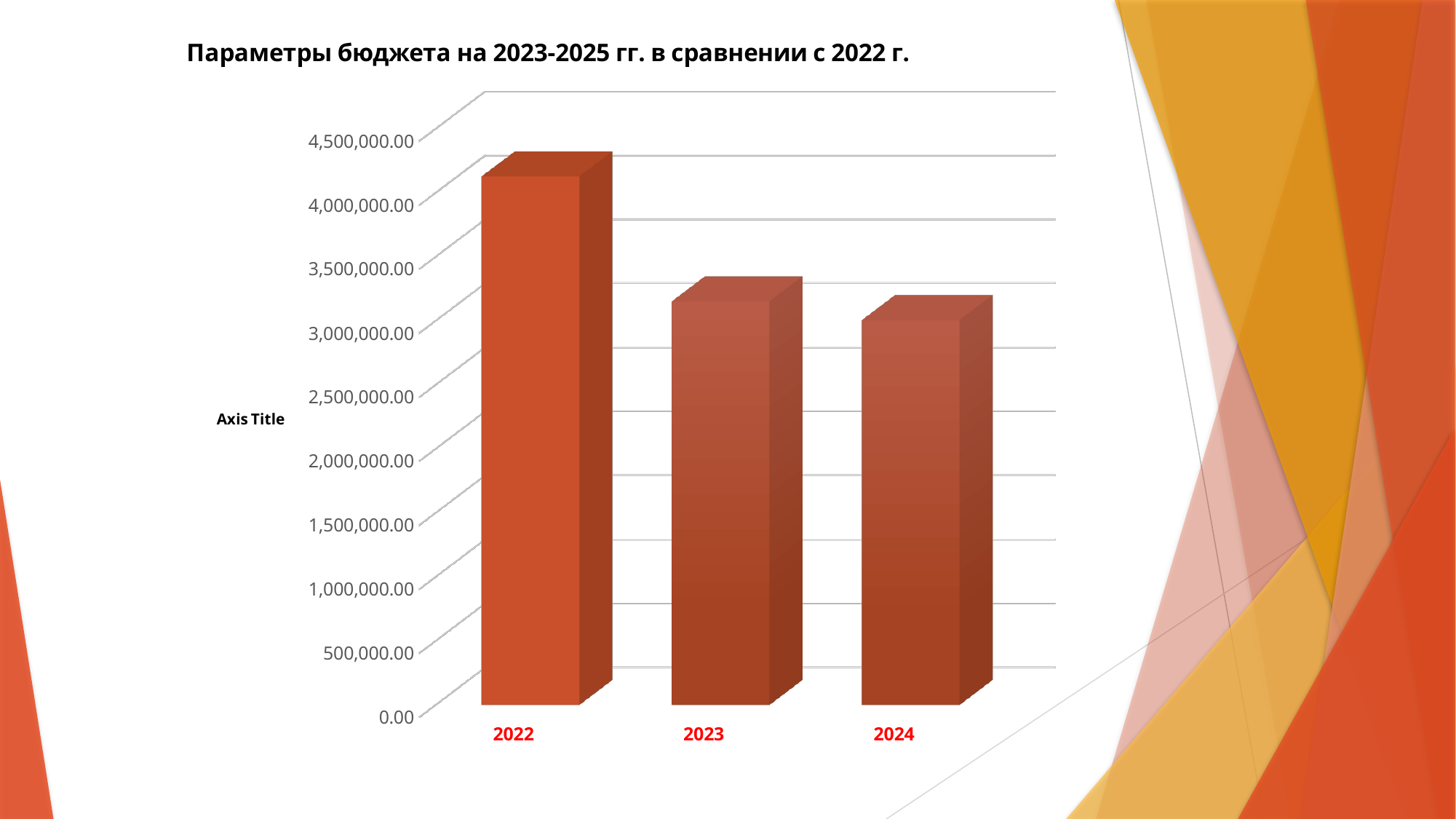
Is the value for 2022 greater or less than 4,500,000.00? less How many bars (categories) are plotted in the chart? 3 Is the value for 2023 greater or less than 3,500,000.00? less Is the value for 2022 greater or less than 4,000,000.00? greater What is the title of the chart? Параметры бюджета на 2023-2025 гг. в сравнении с 2022 г. Which is larger, the value for 2023 or the value for 2024? 2023 What kind of chart is shown on the slide? bar chart Which is larger, the value for 2022 or the value for 2023? 2022 Which year has the highest value in the chart? 2022 Which year has the lowest value in the chart? 2024 Do the values rise or fall from 2022 to 2024? fall